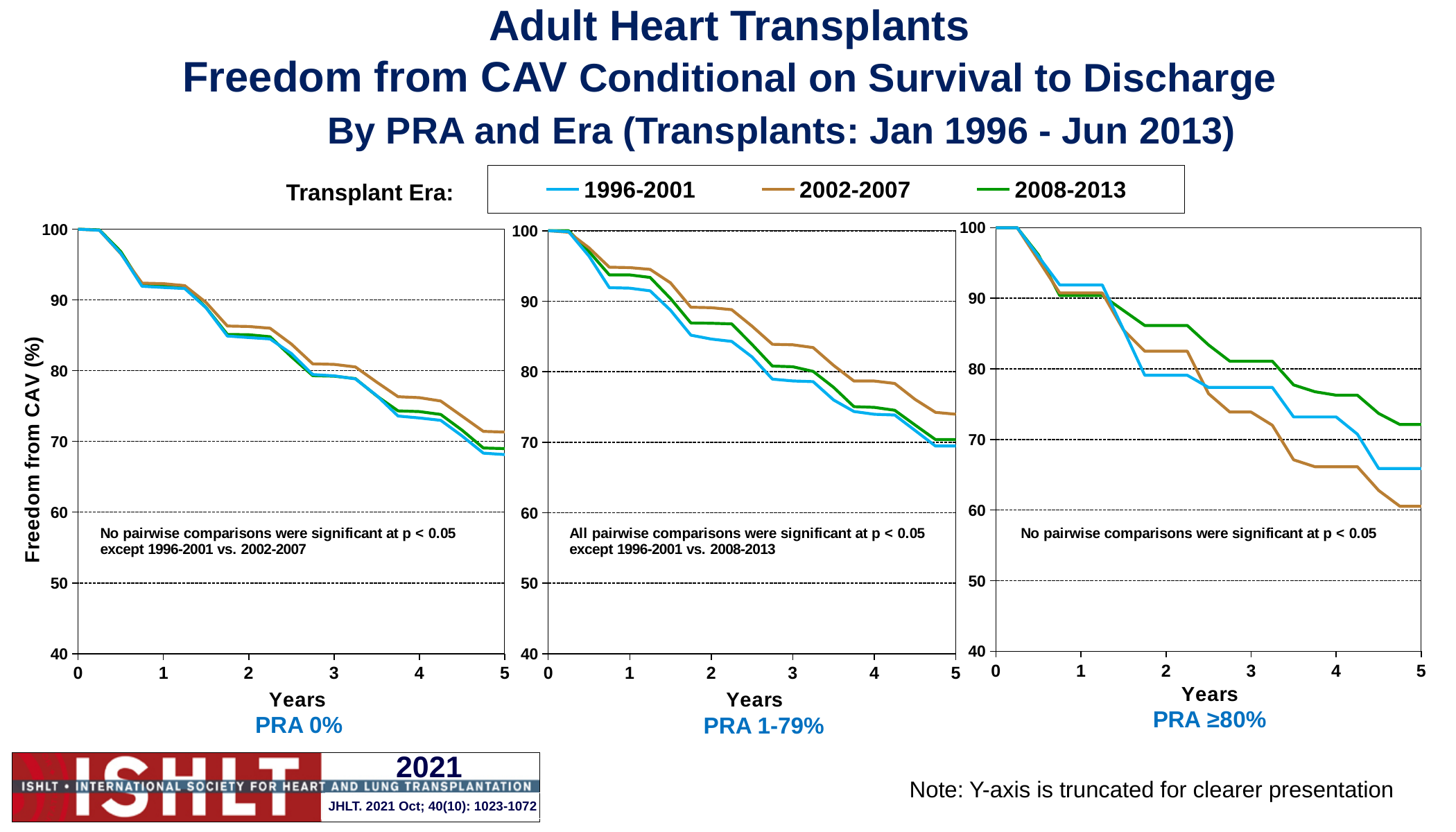
In the PRA 1-79% chart, at year 5, which is larger: the value for 2002-2007 or the value for 1996-2001? 2002-2007 What kind of chart is used in each of the three panels on the slide? line chart In the PRA ≥80% chart, which transplant era has the highest freedom from CAV at year 5? 2008-2013 In the PRA 0% chart, is the value for 1996-2001 at year 2 greater or less than 80? greater In the PRA ≥80% chart, is the value for 2002-2007 at year 5 greater or less than 70? less In the PRA ≥80% chart, is the value for 1996-2001 at year 5 greater or less than 70? less What is the label on the y-axis of the charts? Freedom from CAV (%) How many transplant eras does the legend list? 3 How many charts (PRA groups) are shown on the slide? 3 In the PRA ≥80% chart, do the freedom from CAV values rise or fall as years increase? fall In the PRA ≥80% chart, which transplant era has the lowest freedom from CAV at year 5? 2002-2007